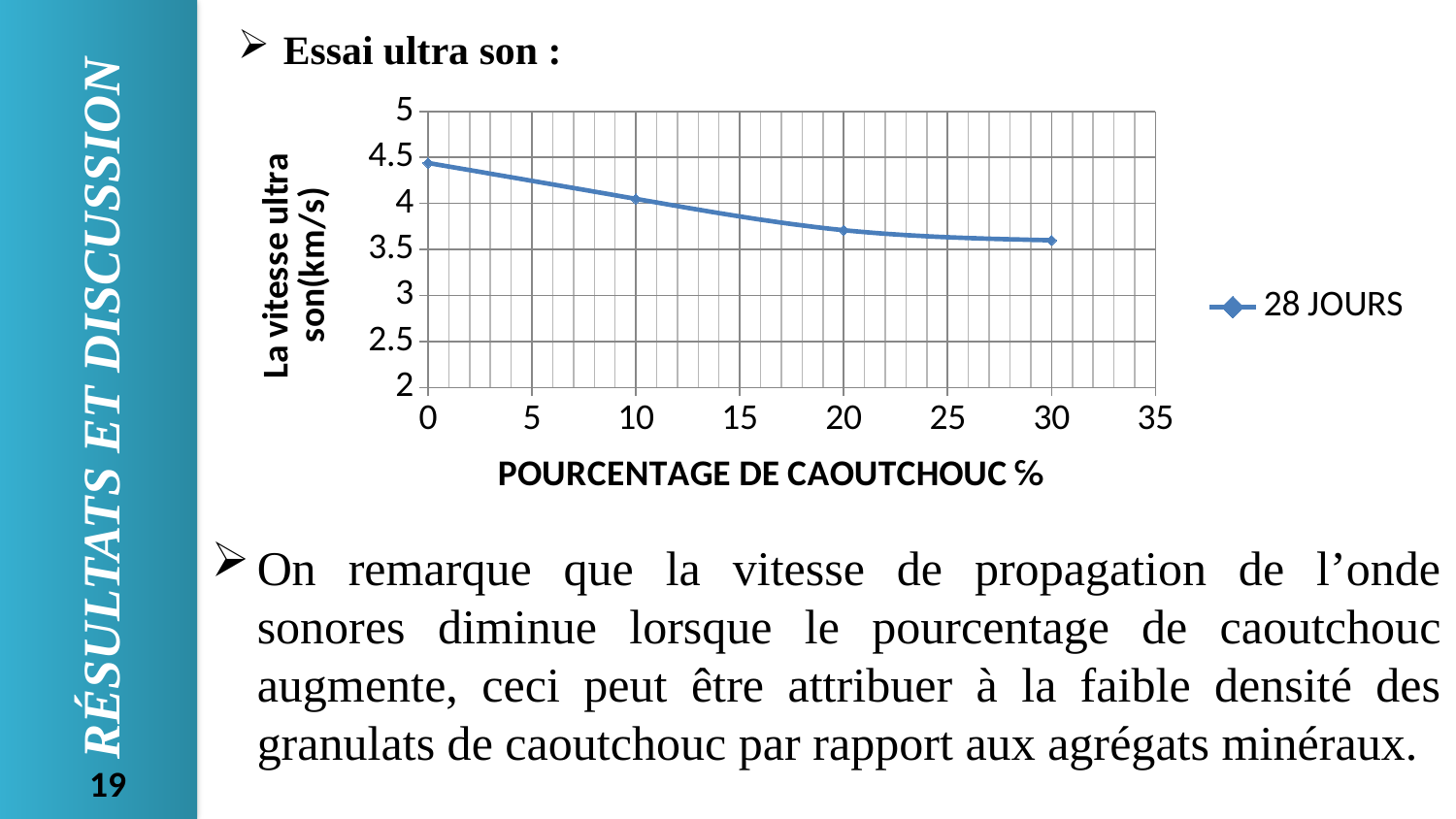
What is the name of the series shown in the legend? 28 JOURS What is the title of the x axis? POURCENTAGE DE CAOUTCHOUC % Does the ultrasonic velocity rise or fall as the percentage of rubber increases? Fall Is the value at 10% rubber greater or less than 3.5? greater How many data points are plotted on the line? 4 At which percentage of rubber is the ultrasonic velocity highest? 0 Which is larger, the value at 0% rubber or the value at 20% rubber? 0% rubber Is the value at 30% rubber greater or less than 4? less Is the value at 20% rubber greater or less than 4? less What kind of chart is shown on the slide? Line chart How many series does the legend list? 1